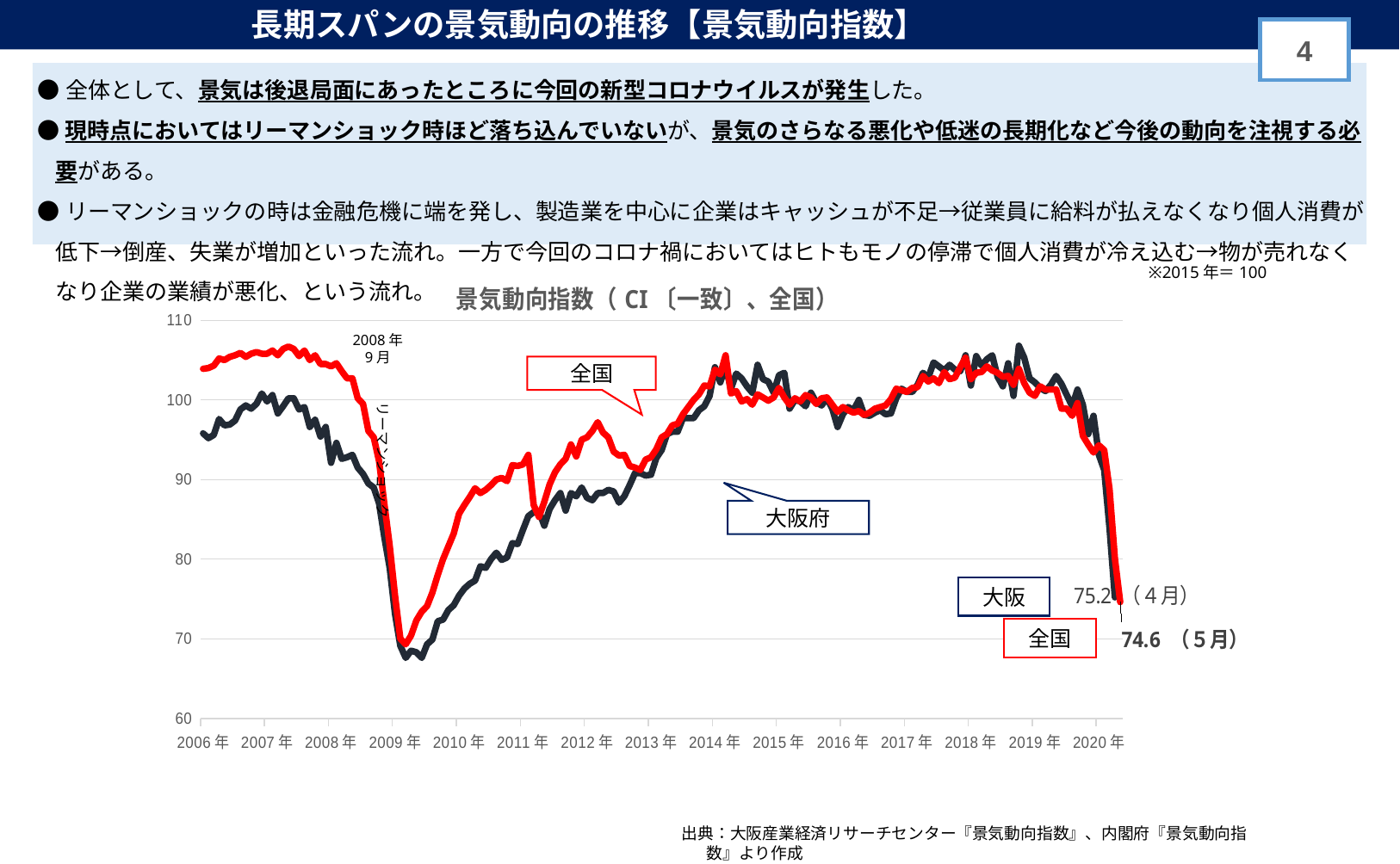
Between 2009年 and 2014年, do the values for 大阪府 rise or fall? rise Which date is annotated on the chart as リーマンショック? 2008年9月 What is the value labelled for 大阪 in 4月 (April) 2020? 75.2 In 2007年, which series is higher, 全国 or 大阪府? 全国 Is the value for 大阪府 at the start of 2006年 greater or less than 100? less How many data series are plotted in the chart? 2 What is the value labelled for 全国 in 5月 (May) 2020? 74.6 Is the value for 全国 in 2007年 greater or less than 100? greater How many year labels are shown on the x axis? 15 What kind of chart is shown on the slide? line chart Is the lowest value for 大阪府 in 2009年 greater or less than 70? less